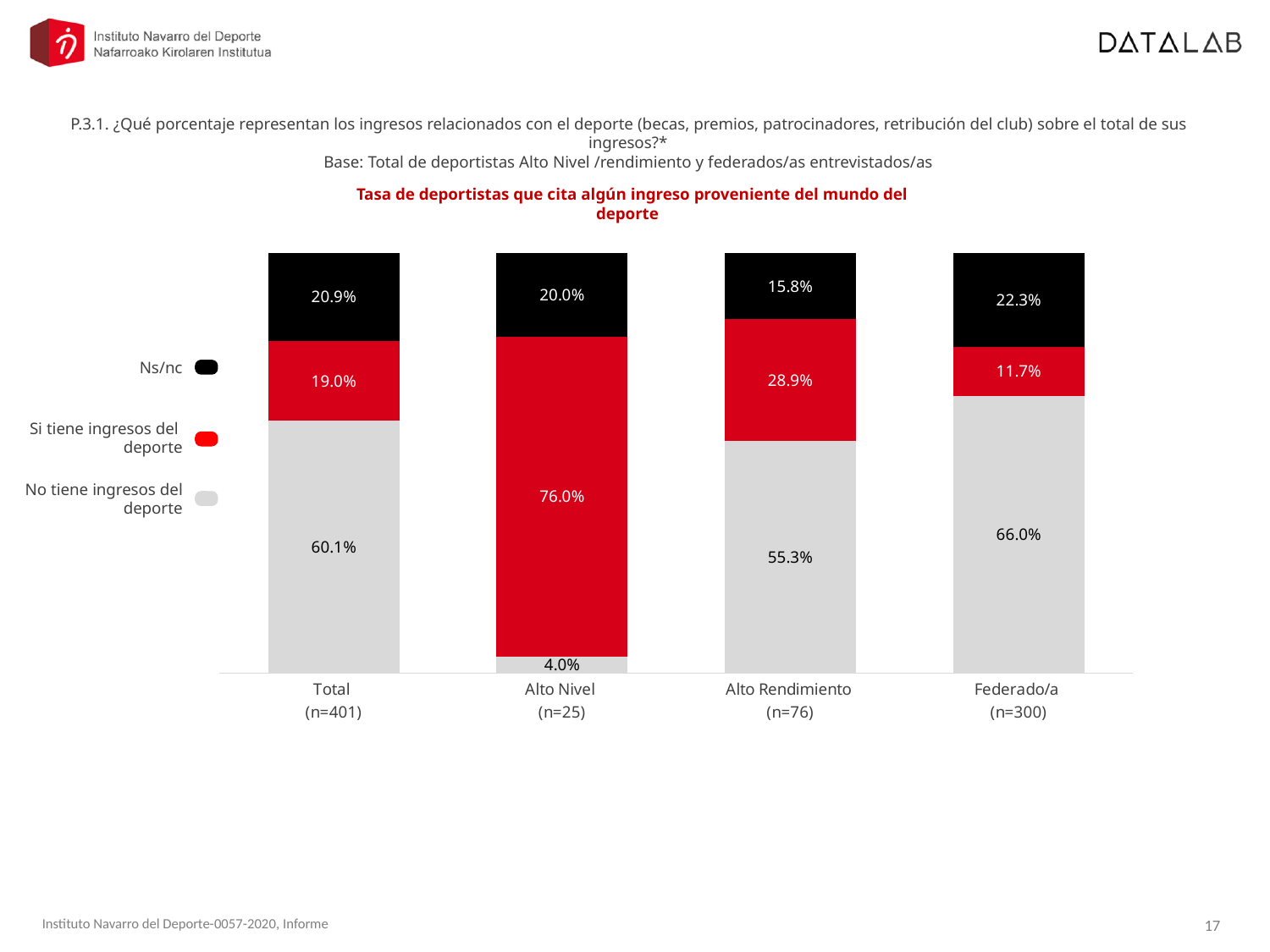
What is the 'No tiene ingresos del deporte' value for Federado/a? 66.0% How many series does the legend list? 3 What is the sample size (n) shown for the Alto Rendimiento group? n=76 What is the Ns/nc value for Alto Rendimiento? 15.8% What kind of chart is shown? Stacked bar chart What is the 'Si tiene ingresos del deporte' value for the Total group? 19.0% What is the difference between the 'Si tiene ingresos del deporte' values for Alto Rendimiento and Federado/a? 17.2% What percentage of Alto Nivel athletes 'Si tiene ingresos del deporte'? 76.0% Which group has the highest 'Si tiene ingresos del deporte' share? Alto Nivel Which is larger: the Ns/nc value for Federado/a or for Alto Nivel? Federado/a Which group has the lowest 'No tiene ingresos del deporte' share? Alto Nivel How many groups are shown on the x axis? 4